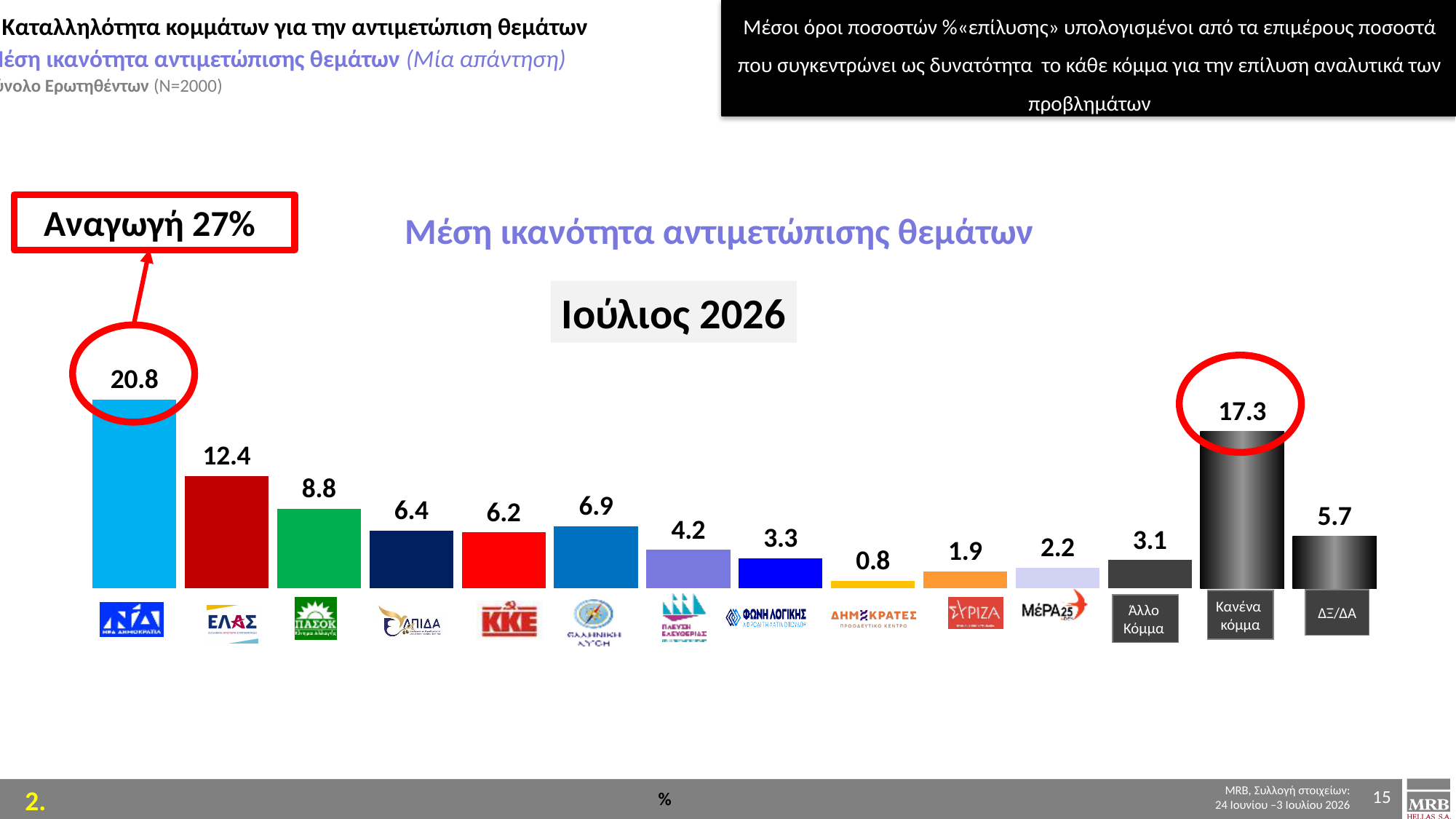
Which bar has the highest value? Νέα Δημοκρατία (20.8) What is the value shown for ΣΥΡΙΖΑ? 1.9 What is the value shown for Νέα Δημοκρατία (ΝΔ)? 20.8 What is the value shown for ΔΞ/ΔΑ? 5.7 What type of chart is shown on the slide? Bar chart What is the difference between the values for Νέα Δημοκρατία and Κανένα κόμμα? 3.5 How many bars are plotted in the chart? 14 Which is larger, the value for ΜέΡΑ25 or the value for Άλλο Κόμμα? Άλλο Κόμμα What is the value shown for ΠΑΣΟΚ? 8.8 Which bar has the lowest value? Δημοκράτες (0.8) What is the value shown for ΚΚΕ? 6.2 What is the value shown for Κανένα κόμμα? 17.3